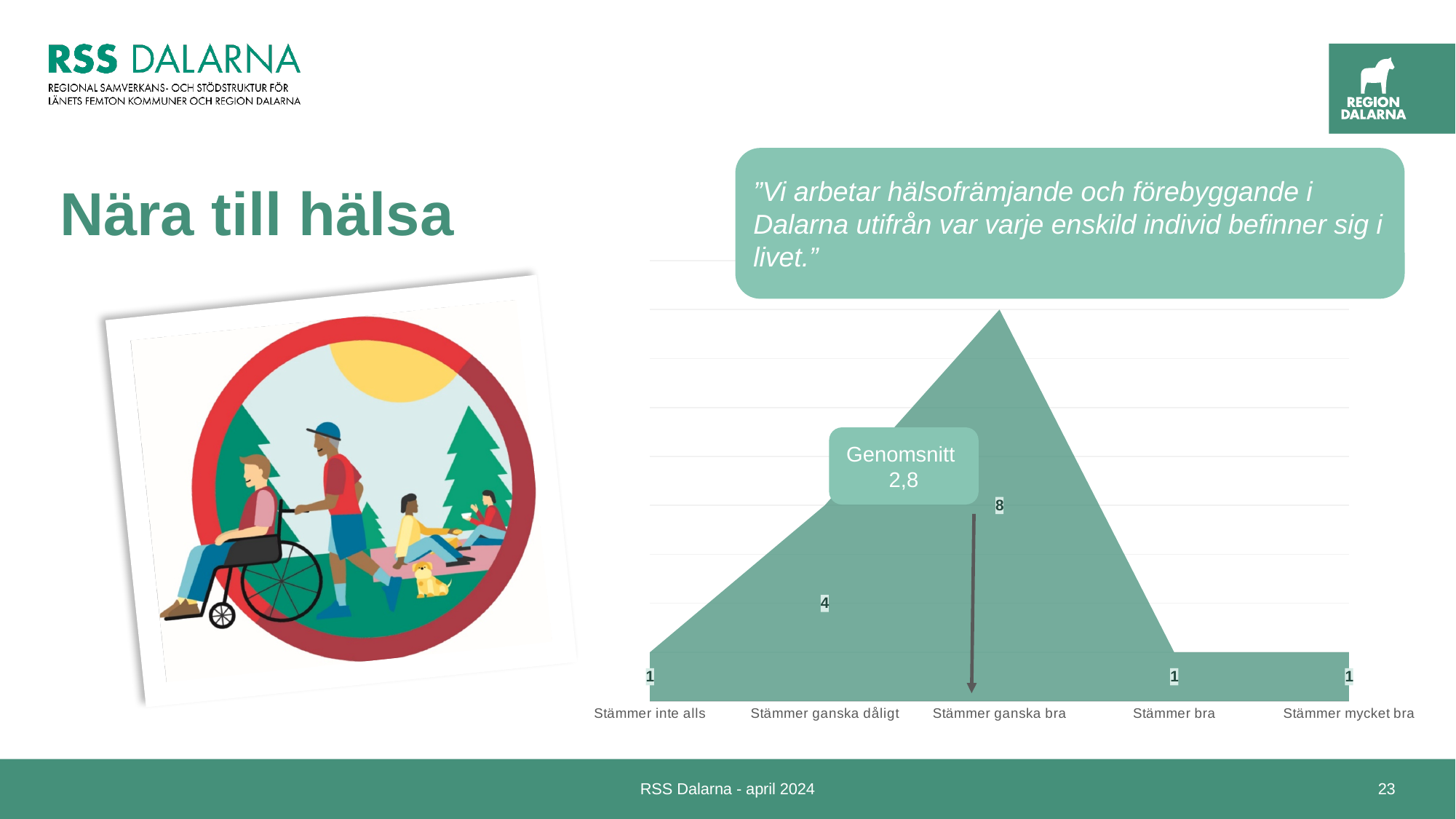
How many categories are shown on the x axis of the chart? 5 What is the total of all the values shown in the chart? 15 What is the value for "Stämmer mycket bra"? 1 What is the difference between the values for "Stämmer ganska bra" and "Stämmer ganska dåligt"? 4 Which category has the highest value? Stämmer ganska bra What is the value for "Stämmer ganska dåligt"? 4 What average (Genomsnitt) value is annotated on the chart? 2,8 What is the difference between the values for "Stämmer ganska dåligt" and "Stämmer bra"? 3 Which is larger, the value for "Stämmer ganska dåligt" or the value for "Stämmer bra"? Stämmer ganska dåligt What is the value for "Stämmer inte alls"? 1 What is the value for "Stämmer ganska bra"? 8 What kind of chart is shown on the slide? Area chart